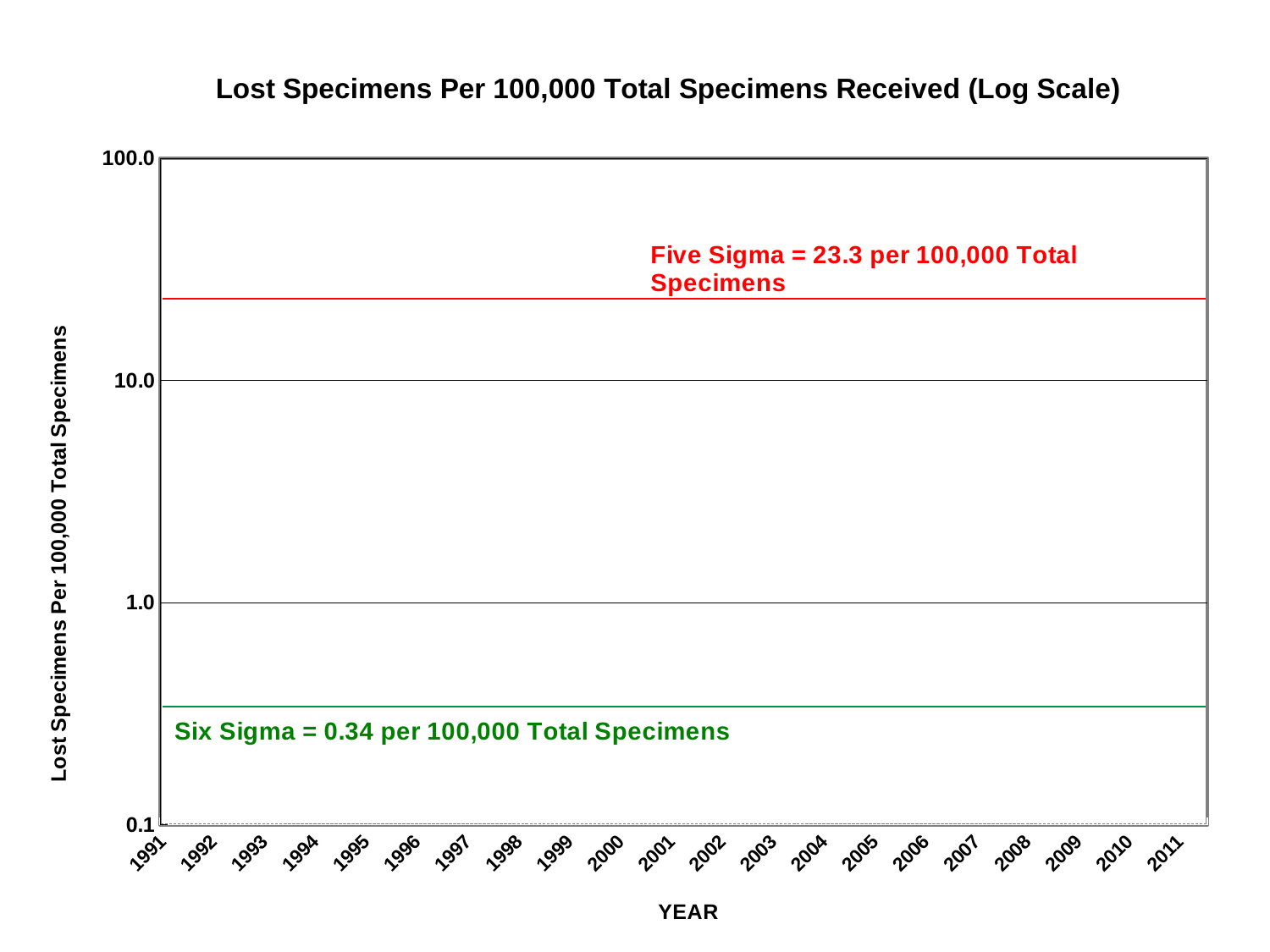
What is the highest value shown on the y axis? 100.0 Is the Six Sigma line greater or less than 1.0 on the y axis? less What is the difference between the Five Sigma value and the Six Sigma value? 22.96 What is the title of the chart? Lost Specimens Per 100,000 Total Specimens Received (Log Scale) What is the last year shown on the x axis? 2011 What is the label of the x axis? YEAR How many years are labelled on the x axis? 21 What is the first year shown on the x axis? 1991 What value does the Five Sigma reference line represent? 23.3 per 100,000 Total Specimens Is the Five Sigma line greater or less than 10.0 on the y axis? greater What value does the Six Sigma reference line represent? 0.34 per 100,000 Total Specimens Which reference line has the larger value, Five Sigma or Six Sigma? Five Sigma